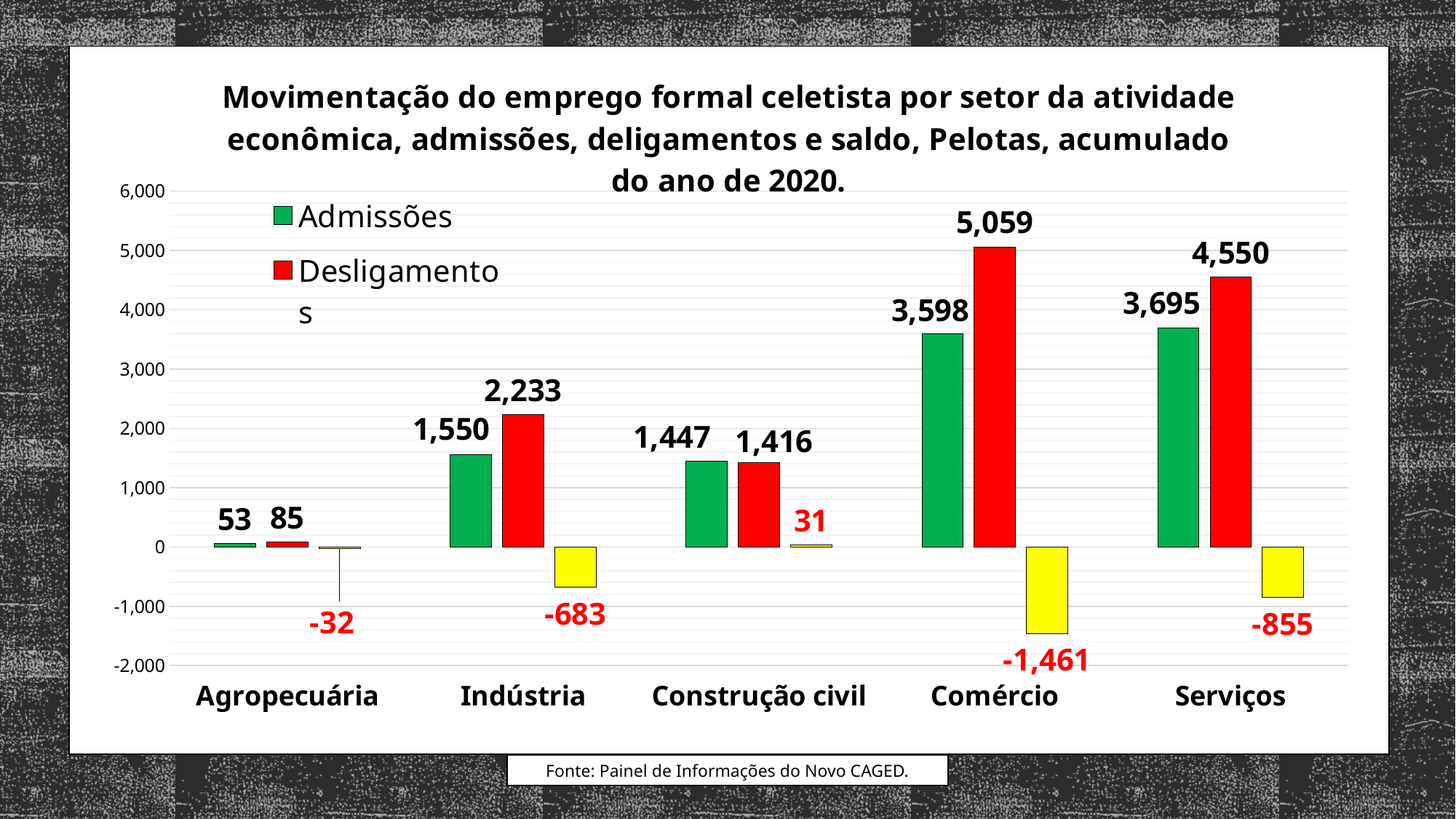
What is the difference between Desligamentos and Admissões for Comércio? 1,461 Which sector has the highest Desligamentos value? Comércio What is the Desligamentos value for Indústria? 2,233 How many sectors are shown on the x axis? 5 Which sector has the lowest Admissões value? Agropecuária What kind of chart is shown on the slide? bar chart Which is larger for Construção civil, Admissões or Desligamentos? Admissões What is the Admissões value for Comércio? 3,598 Is the Admissões value for Serviços greater or less than 3,000? greater What colour are the Admissões bars? green How many series does the legend list? 2 What is the value of the yellow (saldo) bar for Serviços? -855